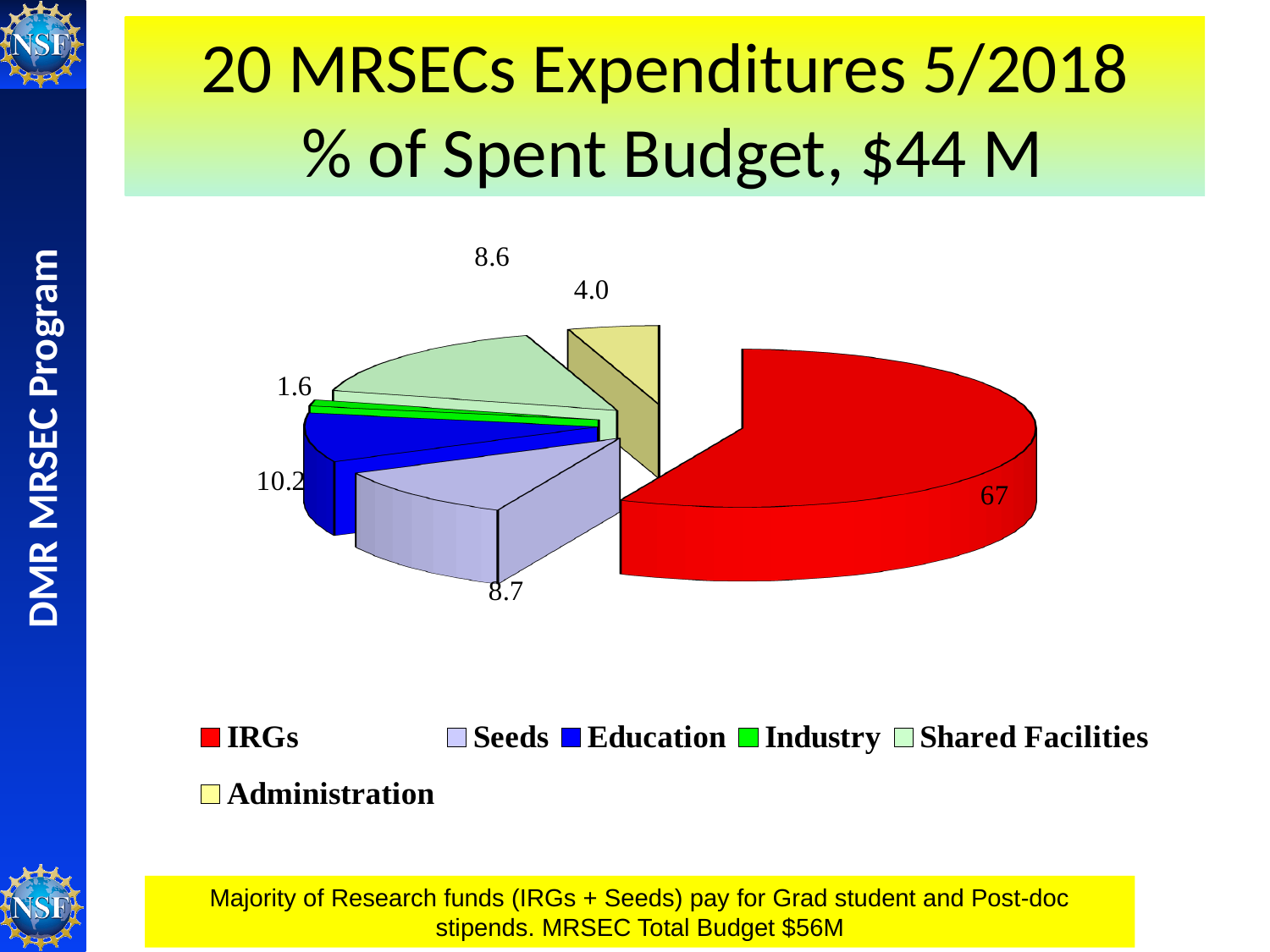
What is the difference between the values for IRGs and Education? 56.8 What is the value shown for Education? 10.2 Which is larger, the slice for IRGs or the slice for Shared Facilities? IRGs Which category has the largest slice of the pie? IRGs What is the value shown for IRGs? 67 Which category has the smallest slice of the pie? Industry What type of chart is shown on the slide? Pie chart What is the difference between the values for Education and Seeds? 1.5 What is the value shown for Administration? 4.0 What is the value shown for Seeds? 8.7 What is the title of the chart on the slide? 20 MRSECs Expenditures 5/2018 % of Spent Budget, $44 M How many categories does the legend list? 6